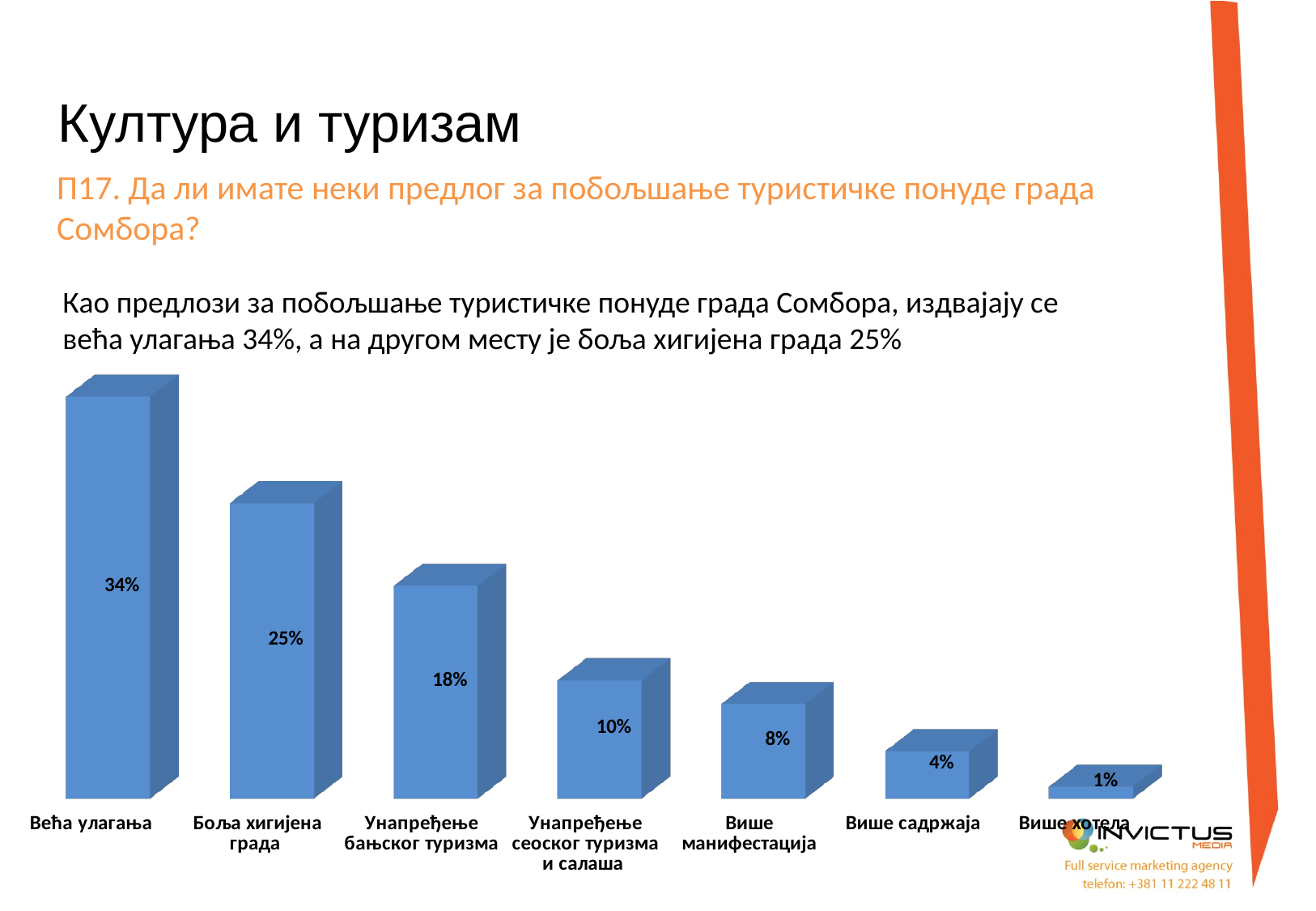
What is the value for Већа улагања? 34% Which category has the highest value? Већа улагања What is the difference between the values for Унапређење бањског туризма and Унапређење сеоског туризма и салаша? 8% Which is larger, the value for Унапређење сеоског туризма и салаша or the value for Више садржаја? Унапређење сеоског туризма и салаша What kind of chart is shown on the slide? Bar chart What is the value for Унапређење бањског туризма? 18% Which category has the lowest value? Више хотела What is the value for Више манифестација? 8% What is the value for Боља хигијена града? 25% How many categories are shown in the chart? 7 Do the values rise or fall from left to right along the x axis? Fall What is the difference between the values for Већа улагања and Боља хигијена града? 9%